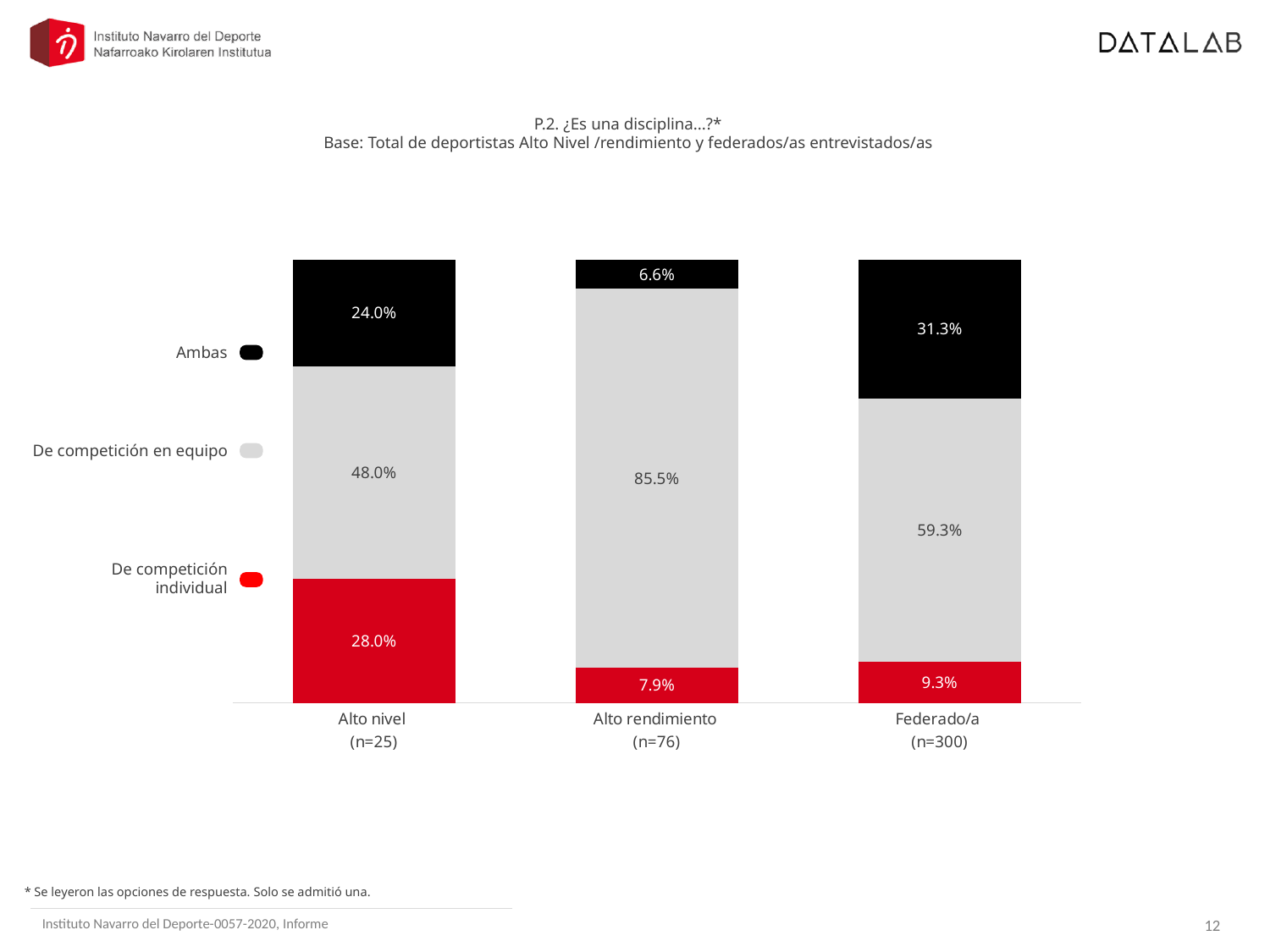
What kind of chart is shown on the slide? Stacked bar chart Which category has the lowest 'Ambas' value? Alto rendimiento How many series does the legend list? 3 What is the 'Ambas' value for Federado/a? 31.3% What is the total of the stacked bar for Alto nivel? 100.0% How many categories are shown on the x axis? 3 What is the 'De competición individual' value for Alto rendimiento? 7.9% What percentage of Alto nivel athletes are in 'De competición en equipo'? 48.0% Which colour represents 'De competición individual' in the legend? Red Which category has the highest 'De competición en equipo' value? Alto rendimiento What is the difference between the 'De competición en equipo' values for Alto rendimiento and Federado/a? 26.2% Which is larger: the 'De competición individual' value for Alto nivel or for Federado/a? Alto nivel